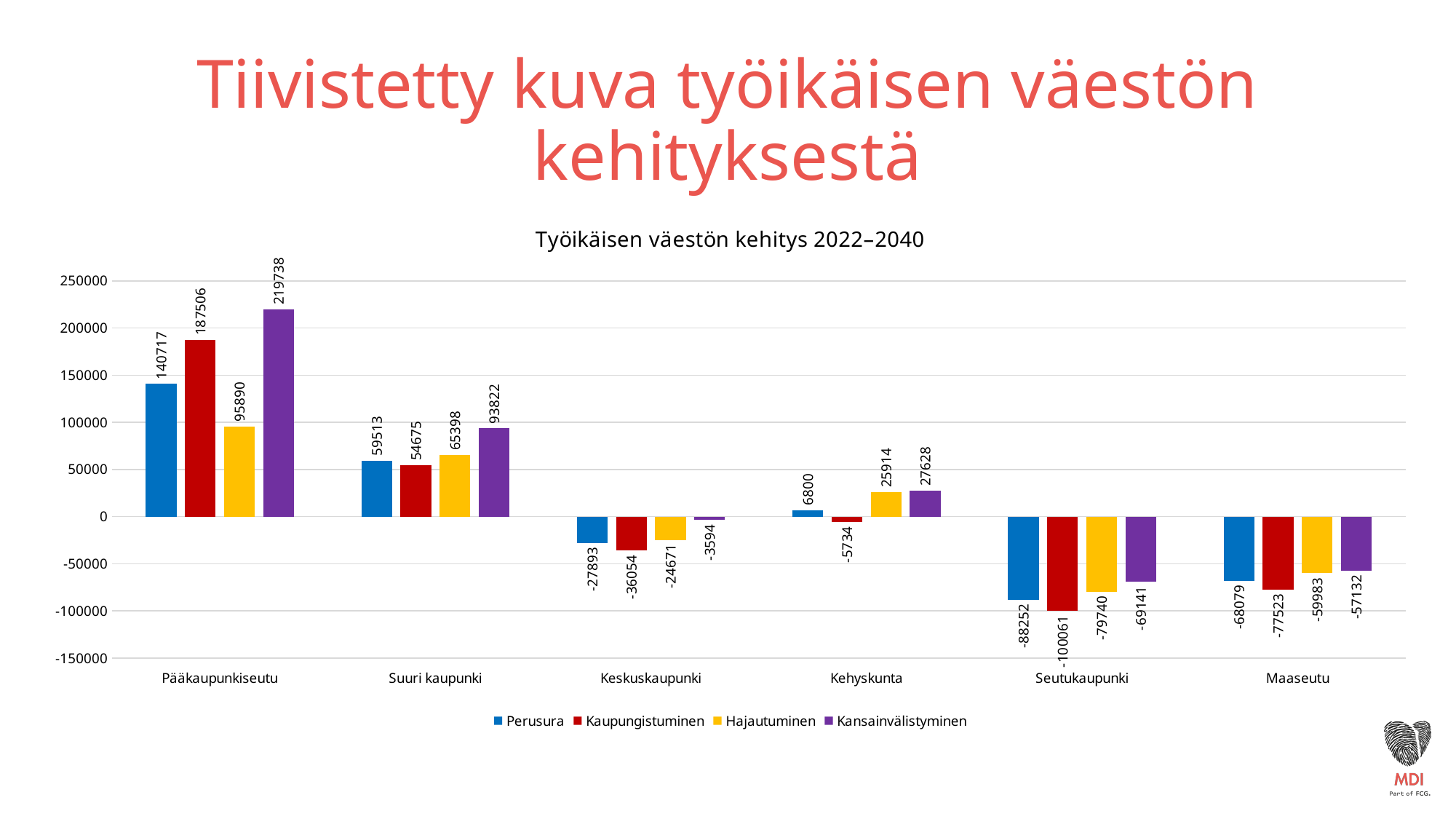
Which category has the highest Perusura value? Pääkaupunkiseutu In Kehyskunta, what is the difference between the Kansainvälistyminen and Hajautuminen values? 1714 How many categories are shown on the x axis? 6 In Suuri kaupunki, which is larger: Hajautuminen or Kaupungistuminen? Hajautuminen What is the title of the chart? Työikäisen väestön kehitys 2022–2040 What is the value for Kaupungistuminen in Kehyskunta? -5734 What is the value for Kaupungistuminen in Seutukaupunki? -100061 What is the value for Kansainvälistyminen in Pääkaupunkiseutu? 219738 Which category has the lowest Hajautuminen value? Seutukaupunki In Pääkaupunkiseutu, how much larger is the Kaupungistuminen value than the Perusura value? 46789 How many series does the legend list? 4 What kind of chart is shown on the slide? Bar chart